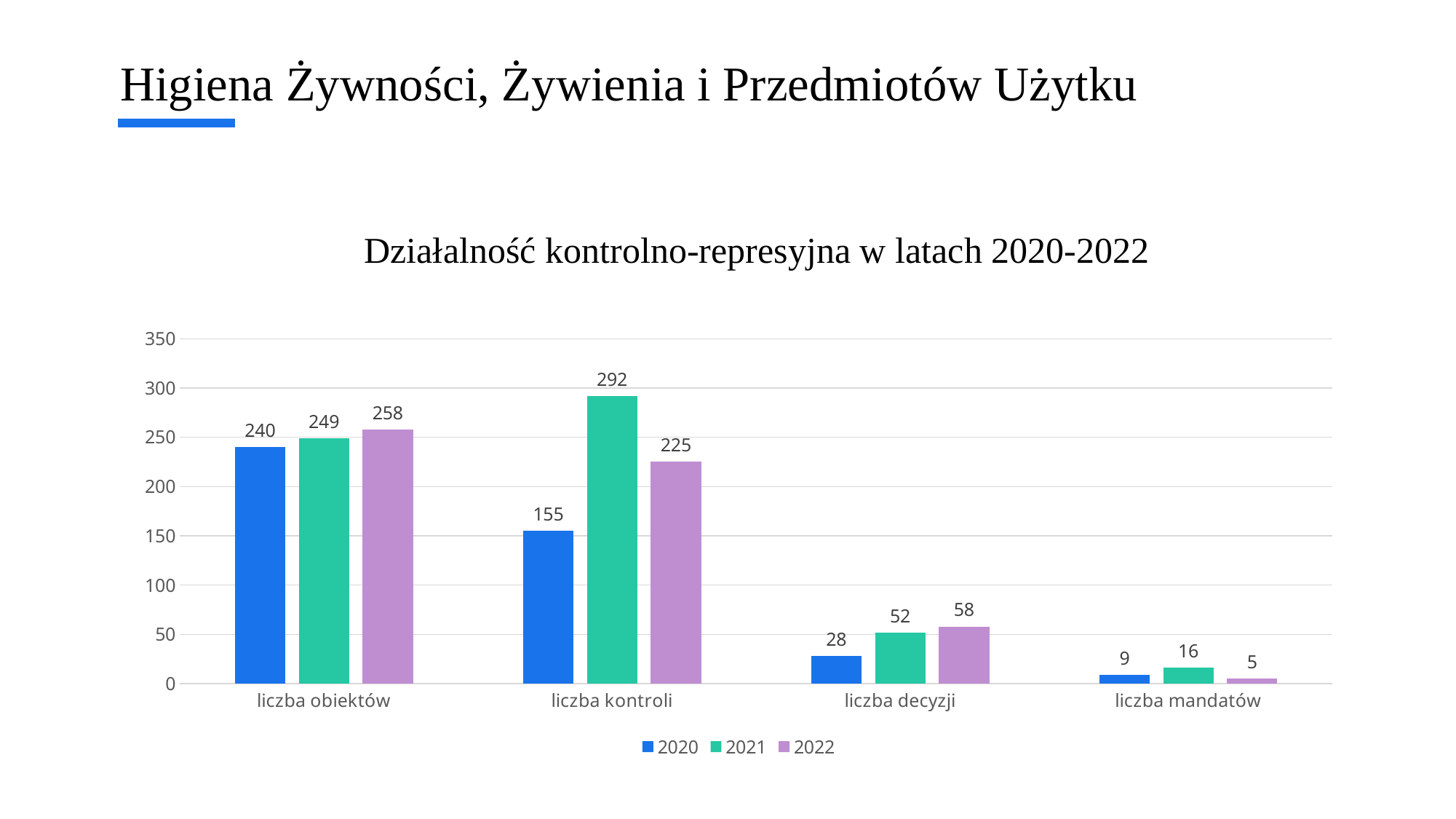
What is the difference between the 2021 and 2022 values in the 'liczba kontroli' category? 67 What is the difference between the 2022 and 2020 values in the 'liczba decyzji' category? 30 How many series does the legend list? 3 Which year has the lowest value in the 'liczba mandatów' category? 2022 What kind of chart is shown on the slide? bar chart What is the value for 2021 in the 'liczba kontroli' category? 292 What is the title of the chart? Działalność kontrolno-represyjna w latach 2020-2022 How many categories are shown on the x axis? 4 What is the value for 2020 in the 'liczba mandatów' category? 9 Which year has the highest value in the 'liczba kontroli' category? 2021 Which is larger: the 2020 value for 'liczba obiektów' or the 2022 value for 'liczba kontroli'? 2020 value for liczba obiektów What is the value for 2022 in the 'liczba obiektów' category? 258